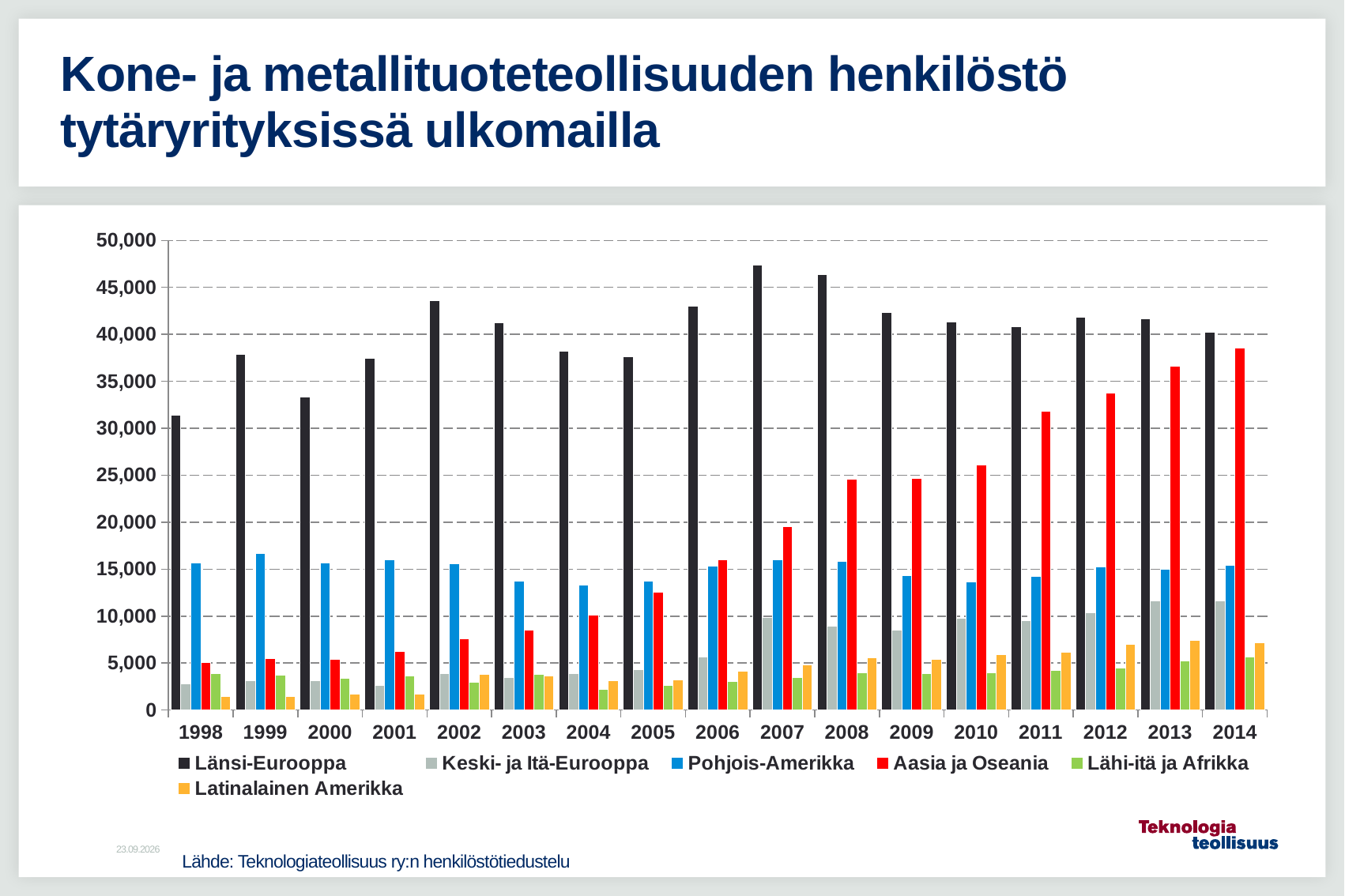
How many years are shown on the x axis? 17 In 2008, which is larger: Aasia ja Oseania or Pohjois-Amerikka? Aasia ja Oseania Is the value for Pohjois-Amerikka in 2010 greater or less than 15,000? less In which year is the value for Länsi-Eurooppa lowest? 1998 Is the value for Länsi-Eurooppa in 2007 greater or less than 45,000? greater How many series does the legend list? 6 Is the value for Latinalainen Amerikka in 1998 greater or less than 5,000? less Does the value for Aasia ja Oseania generally rise or fall from 1998 to 2014? rise In which year is the value for Länsi-Eurooppa highest? 2007 What kind of chart is shown on the slide? bar chart In which year is the value for Aasia ja Oseania highest? 2014